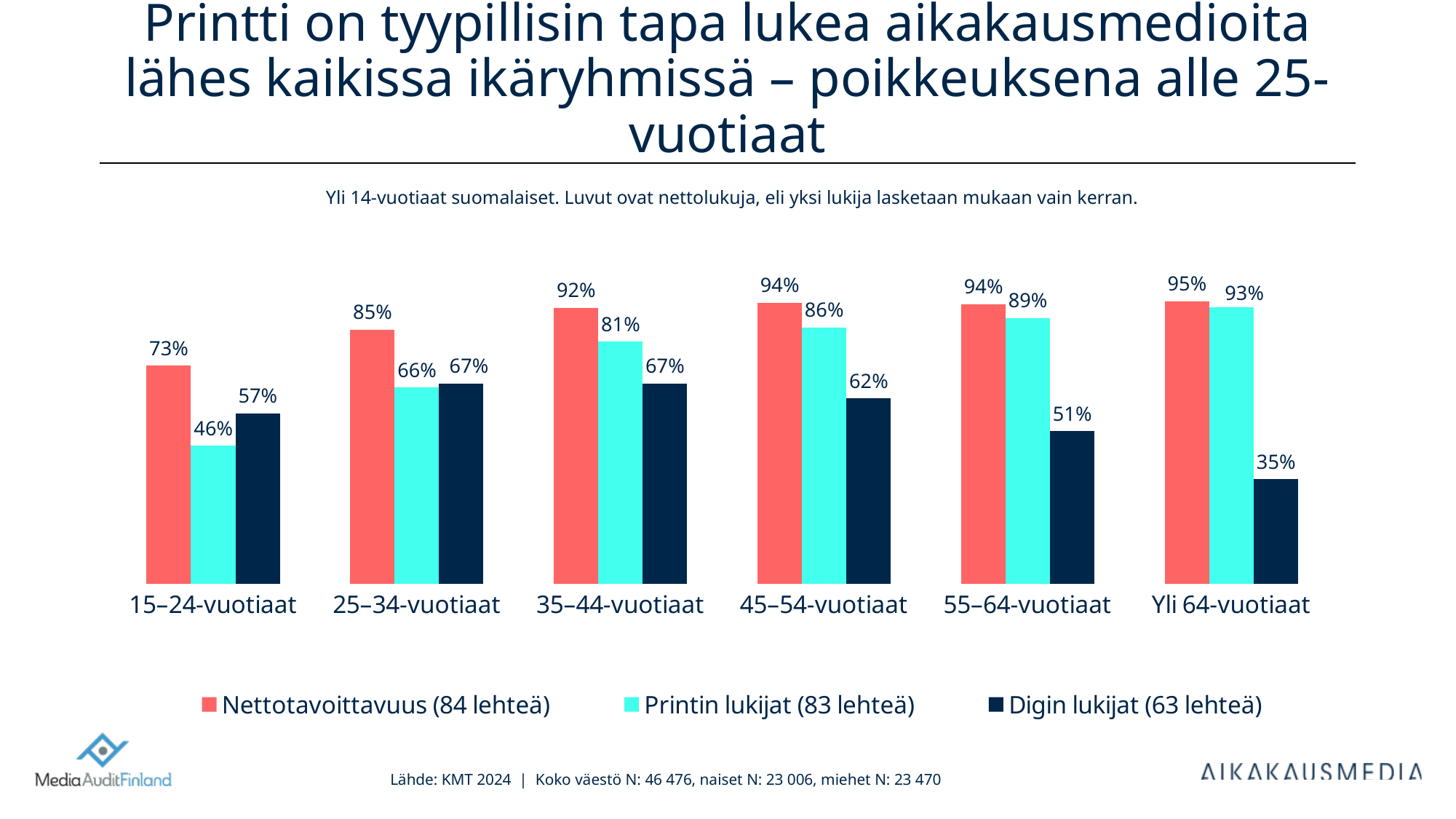
Which age group has the highest value for Digin lukijat (63 lehteä)? 25–34-vuotiaat and 35–44-vuotiaat (tied at 67%) What kind of chart is shown on the slide? Bar chart For 15–24-vuotiaat, which is larger: Printin lukijat or Digin lukijat? Digin lukijat Which age group has the highest value for Nettotavoittavuus (84 lehteä)? Yli 64-vuotiaat Which age group has the lowest value for Printin lukijat (83 lehteä)? 15–24-vuotiaat How many age groups are shown on the x axis? 6 What is the value of Nettotavoittavuus (84 lehteä) for 35–44-vuotiaat? 92% What is the value of Printin lukijat (83 lehteä) for 15–24-vuotiaat? 46% How many series does the legend list? 3 Do the values for Digin lukijat (63 lehteä) generally rise or fall from 25–34-vuotiaat to Yli 64-vuotiaat? Fall What is the difference between Printin lukijat and Digin lukijat for Yli 64-vuotiaat? 58% What is the value of Digin lukijat (63 lehteä) for Yli 64-vuotiaat? 35%